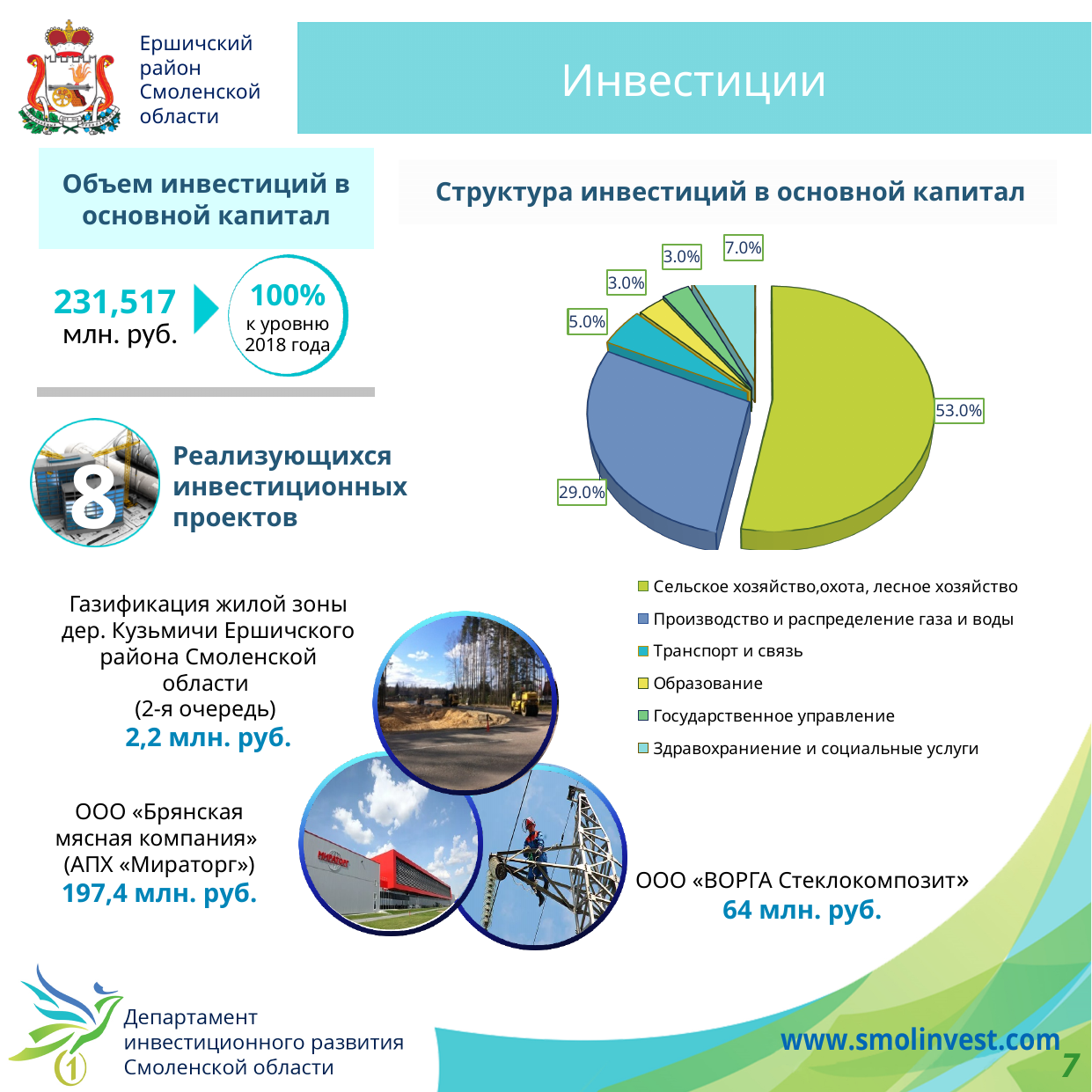
In the pie chart «Структура инвестиций в основной капитал», what is the difference between the shares of «Сельское хозяйство, охота, лесное хозяйство» and «Производство и распределение газа и воды»? 24.0% In the pie chart «Структура инвестиций в основной капитал», which is larger: the share of «Здравоохранение и социальные услуги» or the share of «Транспорт и связь»? Здравоохранение и социальные услуги In the pie chart «Структура инвестиций в основной капитал», which category has the largest share? Сельское хозяйство, охота, лесное хозяйство In the pie chart «Структура инвестиций в основной капитал», what share does «Здравоохранение и социальные услуги» have? 7.0% In the pie chart «Структура инвестиций в основной капитал», what share does «Образование» have? 3.0% In the pie chart «Структура инвестиций в основной капитал», what share does «Транспорт и связь» have? 5.0% In the pie chart «Структура инвестиций в основной капитал», what share does «Производство и распределение газа и воды» have? 29.0% How many categories does the legend of the pie chart «Структура инвестиций в основной капитал» list? 6 What is the title of the pie chart on the slide? Структура инвестиций в основной капитал In the pie chart «Структура инвестиций в основной капитал», what share does «Сельское хозяйство, охота, лесное хозяйство» have? 53.0% In the pie chart «Структура инвестиций в основной капитал», what is the combined share of «Образование» and «Государственное управление»? 6.0% What type of chart is shown under the title «Структура инвестиций в основной капитал»? Pie chart